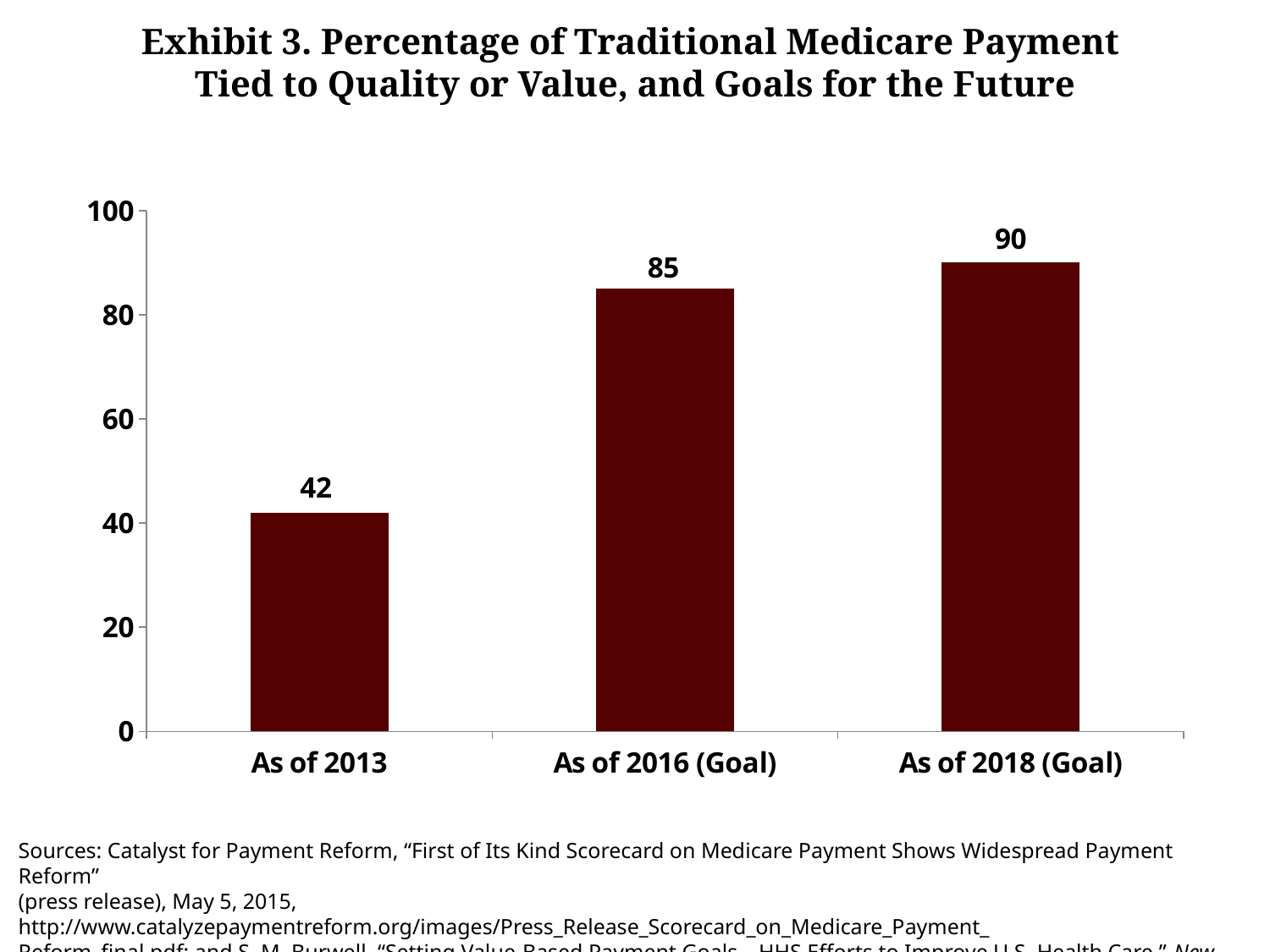
What is the difference between the values for As of 2018 (Goal) and As of 2016 (Goal)? 5 How many categories are shown on the x axis? 3 What kind of chart is shown on the slide? bar chart Which category has the highest value? As of 2018 (Goal) Which category has the lowest value? As of 2013 What is the value for As of 2016 (Goal)? 85 What is the value for As of 2018 (Goal)? 90 Is the value for As of 2013 greater or less than 60? less What is the difference between the values for As of 2016 (Goal) and As of 2013? 43 Which is larger, the value for As of 2013 or the value for As of 2016 (Goal)? As of 2016 (Goal) Do the values rise or fall from left to right along the x axis? rise What is the value for As of 2013? 42